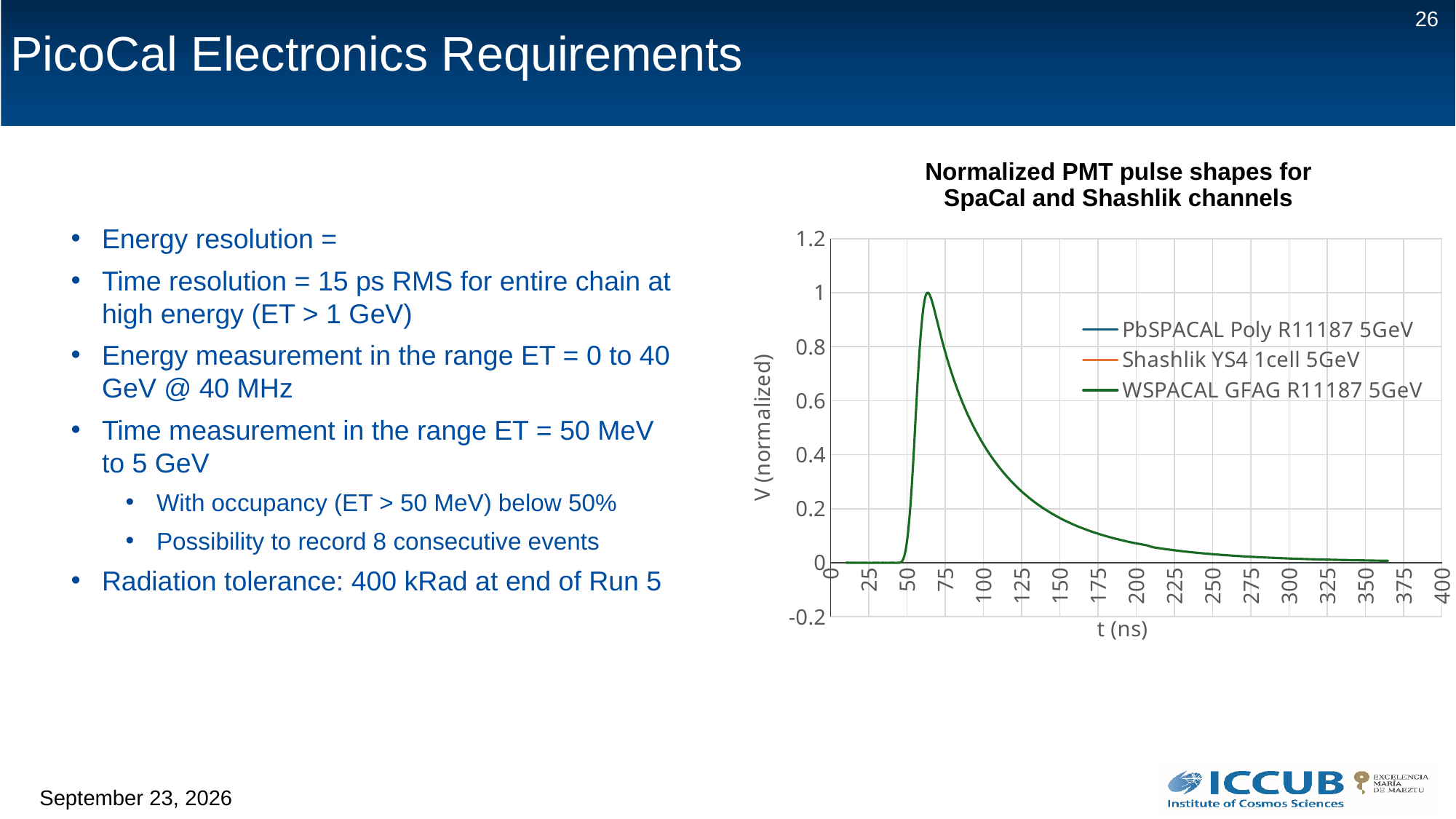
What is the highest value shown on the y axis of the chart? 1.2 Is the value of the pulse curve at t = 200 ns greater or less than 0.2? less Is the value of the pulse curve at t = 25 ns greater or less than 0.2? less What is the title of the chart? Normalized PMT pulse shapes for SpaCal and Shashlik channels What is the label of the x axis of the chart? t (ns) Is the value of the pulse curve at t = 75 ns greater or less than 0.6? greater What kind of chart is shown on the slide? line chart What is the peak value reached by the pulse curve on the y axis? 1 Do the values of the pulse curve rise or fall along the x axis between t = 100 ns and t = 350 ns? fall Is the value of the pulse curve at t = 75 ns larger or smaller than its value at t = 250 ns? larger How many series does the legend of the chart list? 3